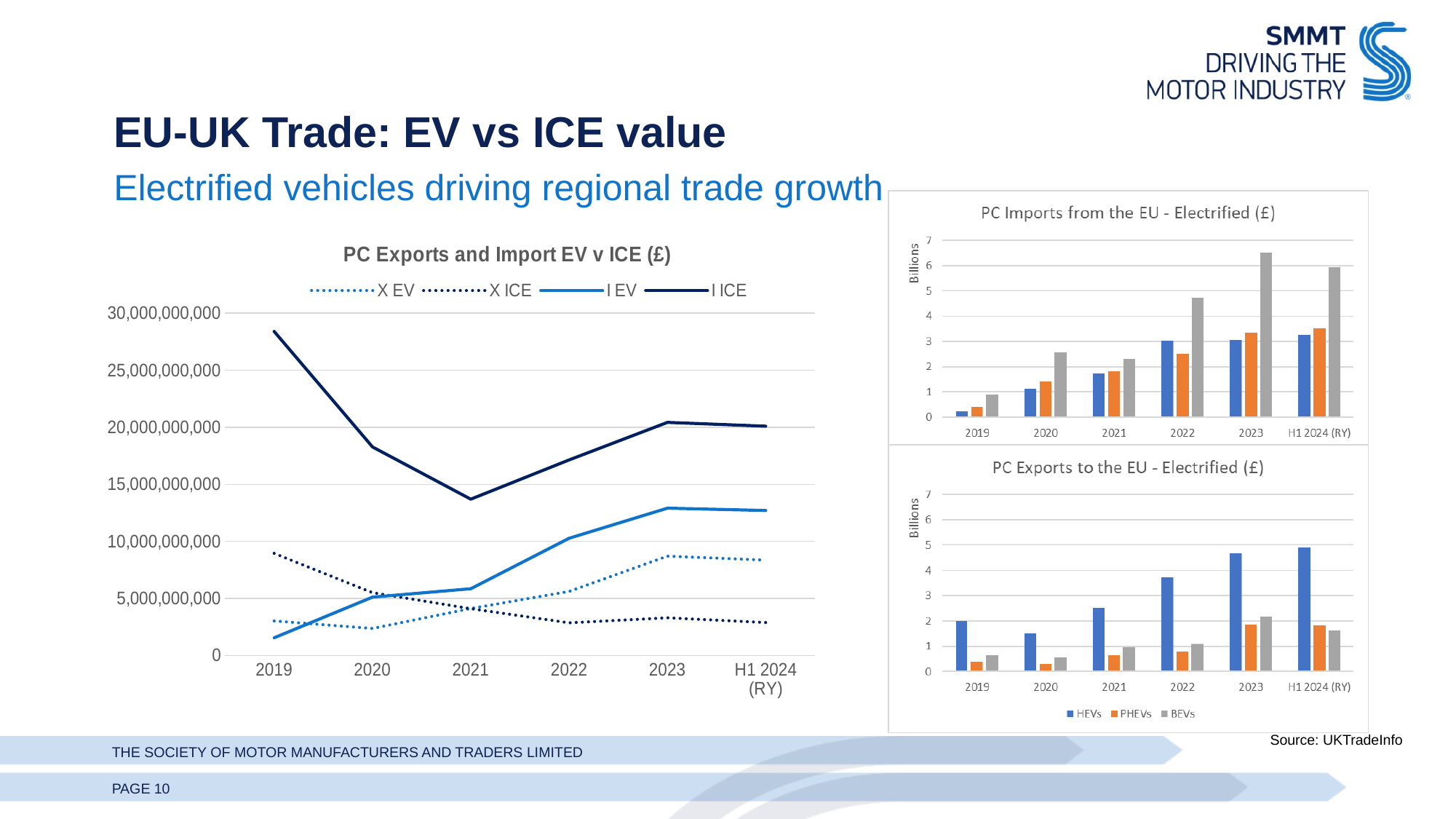
What kind of chart is 'PC Exports and Import EV v ICE (£)'? line chart In 'PC Imports from the EU - Electrified (£)', which is larger in 2022, HEVs or BEVs? BEVs In 'PC Imports from the EU - Electrified (£)', is the value for BEVs in 2023 greater or less than 6? greater In 'PC Exports and Import EV v ICE (£)', is the value for I ICE in 2019 greater or less than 25,000,000,000? greater How many series does the legend of 'PC Exports and Import EV v ICE (£)' list? 4 In 'PC Exports to the EU - Electrified (£)', is the value for HEVs in 2022 greater or less than 3? greater In 'PC Exports to the EU - Electrified (£)', which series has the highest bar in H1 2024 (RY)? HEVs In 'PC Exports and Import EV v ICE (£)', which series has the highest value in 2019? I ICE In 'PC Exports and Import EV v ICE (£)', does the I EV series rise or fall from 2019 to 2023? rise How many periods are shown on the x axis of 'PC Exports and Import EV v ICE (£)'? 6 In 'PC Imports from the EU - Electrified (£)', which series has the highest bar in 2023? BEVs